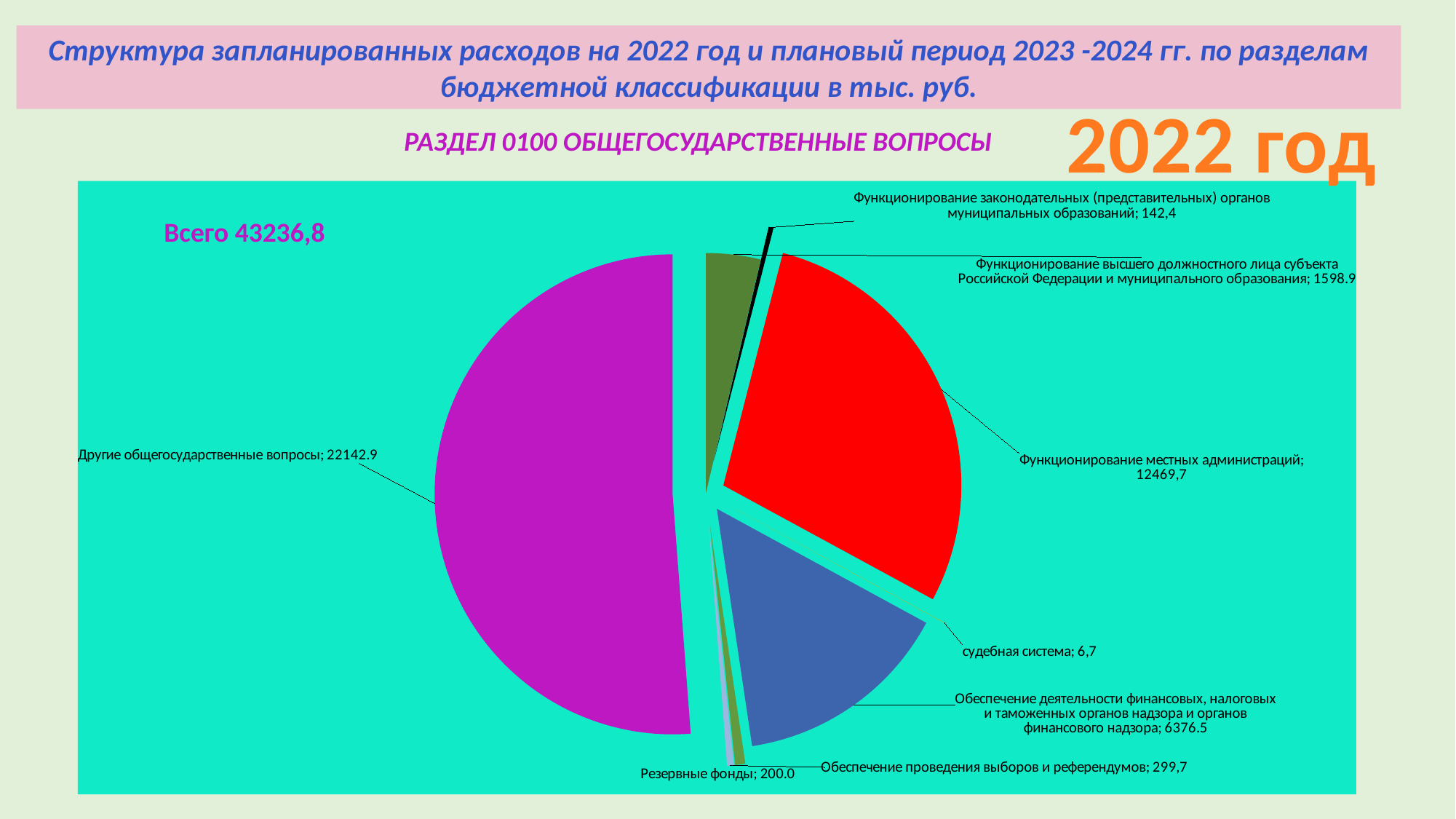
What is the value for Функционирование местных администраций? 12469,7 What total (Всего) is shown on the chart? 43236,8 What is the value for Другие общегосударственные вопросы? 22142.9 What is the value for Обеспечение проведения выборов и референдумов? 299,7 What is the value for Функционирование высшего должностного лица субъекта Российской Федерации и муниципального образования? 1598.9 Which is larger: Обеспечение деятельности финансовых, налоговых и таможенных органов надзора и органов финансового надзора or Функционирование высшего должностного лица субъекта Российской Федерации и муниципального образования? Обеспечение деятельности финансовых, налоговых и таможенных органов надзора и органов финансового надзора Which category has the smallest value? судебная система What kind of chart is shown on the slide? Pie chart Which category has the largest value? Другие общегосударственные вопросы How many slices does the pie chart have? 8 What is the value for Резервные фонды? 200.0 What is the difference between Другие общегосударственные вопросы and Функционирование местных администраций? 9673.2